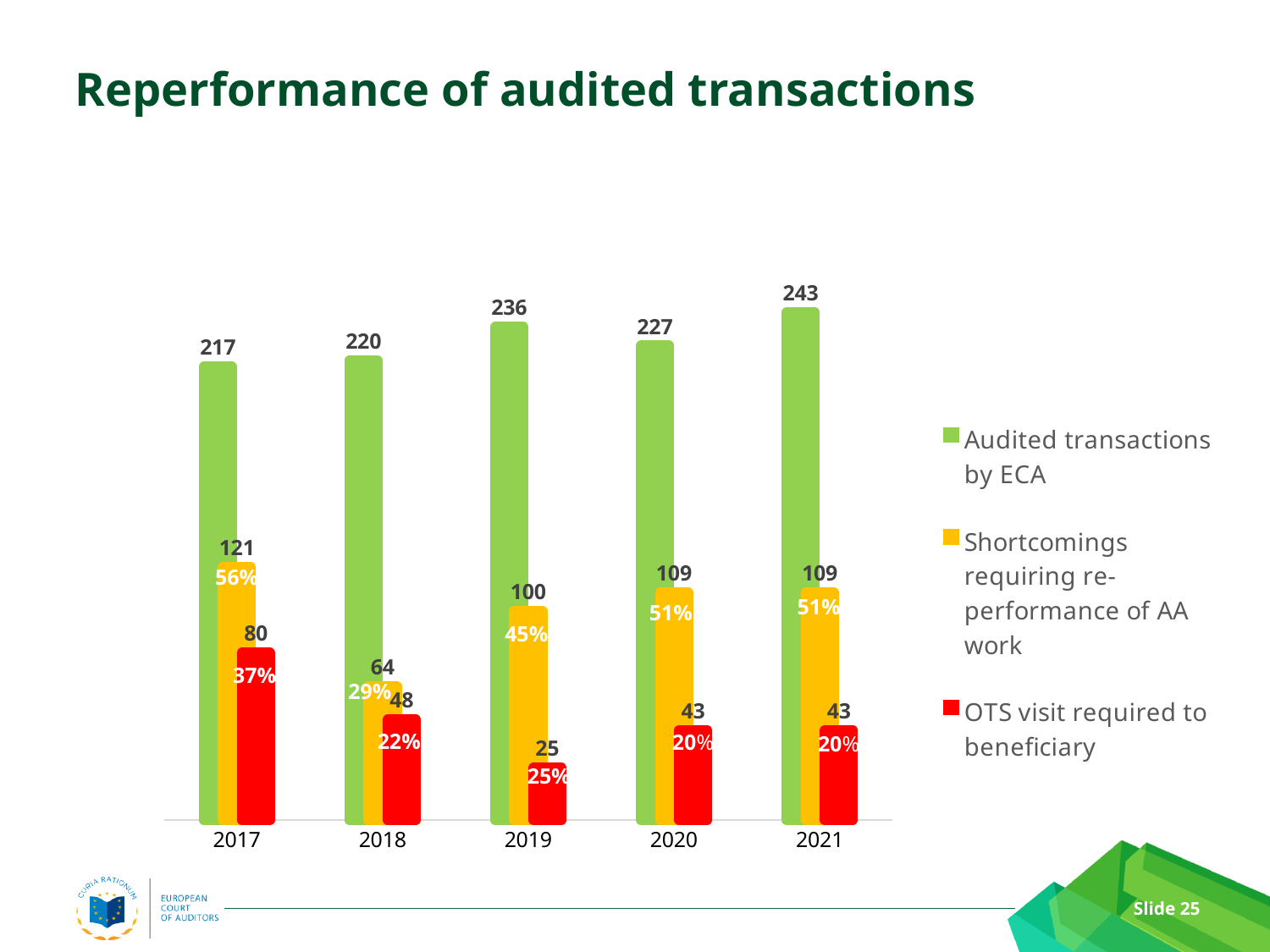
What kind of chart is shown on the slide? Bar chart What is the value for Shortcomings requiring re-performance of AA work in 2017? 121 In which year was the value for Shortcomings requiring re-performance of AA work lowest? 2018 What is the difference between audited transactions by ECA in 2021 and in 2017? 26 In which year were audited transactions by ECA highest? 2021 What is the value for OTS visit required to beneficiary in 2018? 48 How many audited transactions by ECA were there in 2019? 236 How many years are shown on the x axis? 5 Which is larger: Shortcomings requiring re-performance of AA work in 2019 or in 2020? 2020 Do the values for audited transactions by ECA rise or fall from 2017 to 2021? Rise What percentage is shown on the OTS visit required to beneficiary bar for 2019? 25% How many series does the legend list? 3